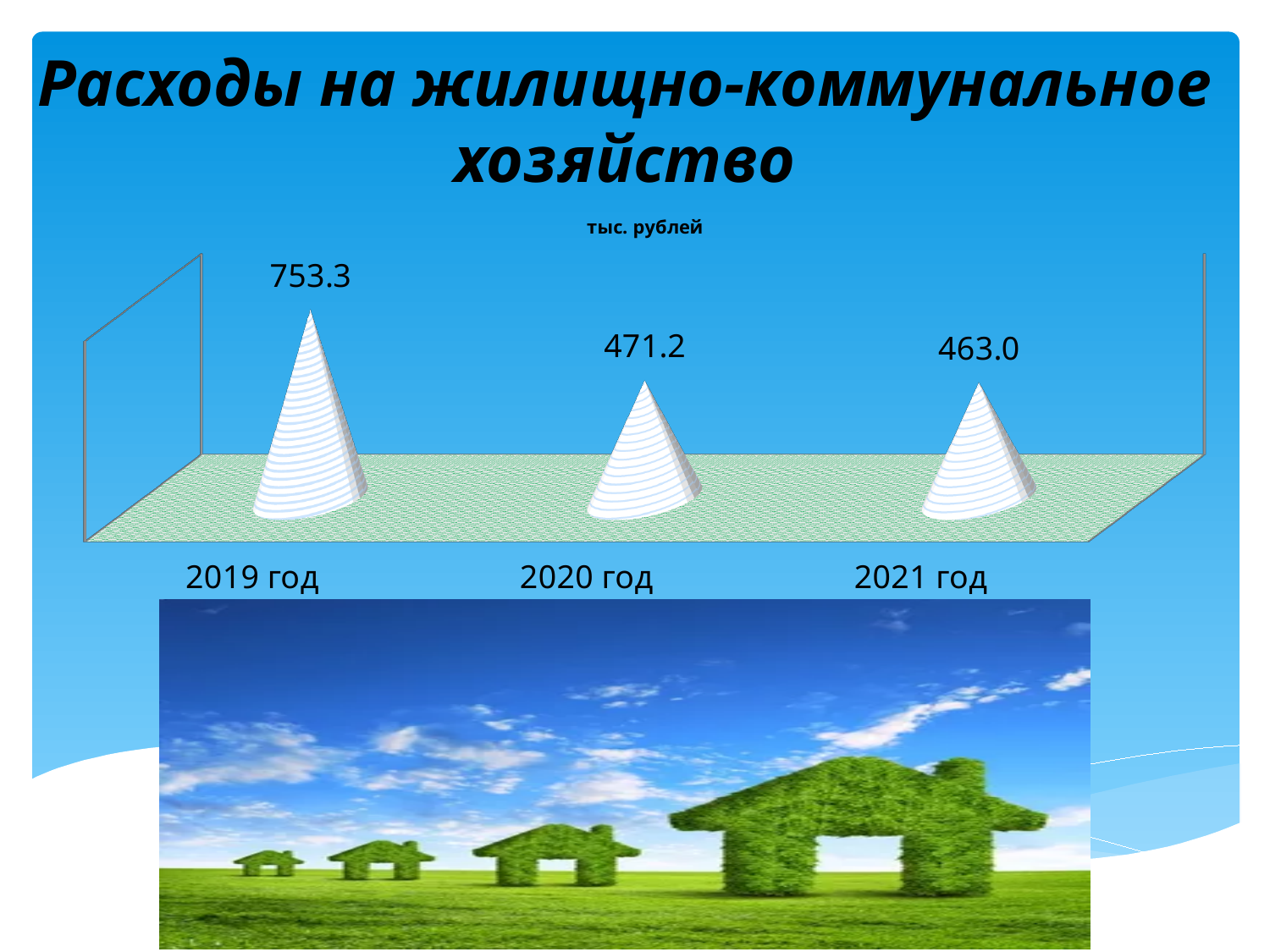
What is the value for 2020 год? 471.2 What is the difference between the values for 2020 год and 2021 год? 8.2 Which year has the highest value? 2019 год Which year has the lowest value? 2021 год What is the value for 2019 год? 753.3 Do the values rise or fall from 2019 год to 2021 год? fall What unit is given in the chart title? тыс. рублей What is the difference between the values for 2019 год and 2020 год? 282.1 Which is larger, the value for 2019 год or the value for 2021 год? 2019 год What is the value for 2021 год? 463.0 What kind of chart is shown on the slide? bar chart How many years are shown on the chart? 3